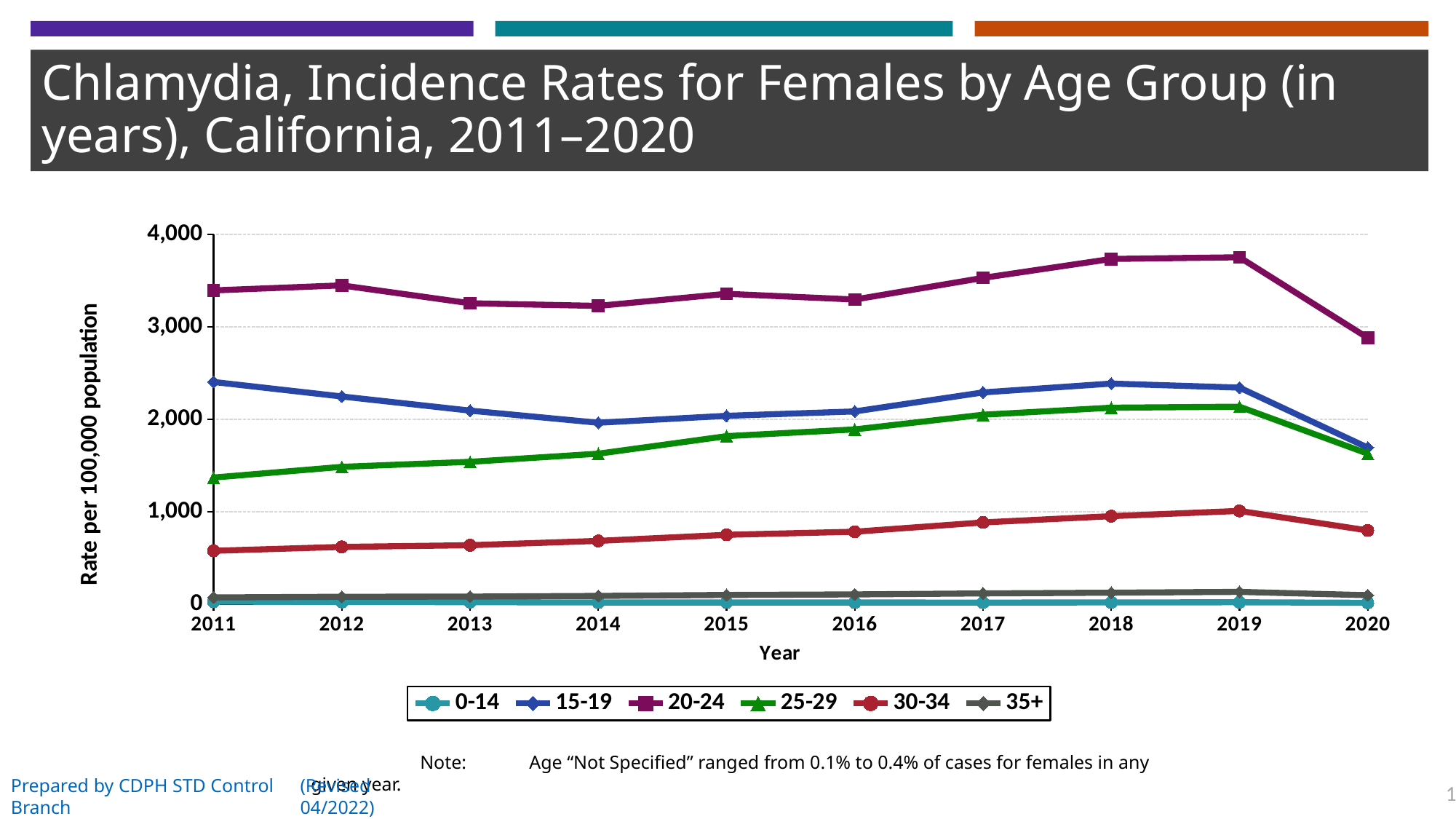
In 2011, which age group has the higher rate, 15-19 or 25-29? 15-19 Is the value for the 30-34 age group in 2011 greater or less than 1,000? less Is the value for the 20-24 age group in 2019 greater or less than 3,000? greater Which age group has the lowest incidence rate across the chart? 0-14 Does the rate for the 25-29 age group rise or fall from 2011 to 2019? rise What kind of chart is shown on the slide? Line chart How many series does the legend list? 6 How many years are plotted along the x axis? 10 What is the label of the y axis? Rate per 100,000 population Is the value for the 25-29 age group in 2011 greater or less than 2,000? less Which age group has the highest incidence rate across the chart? 20-24